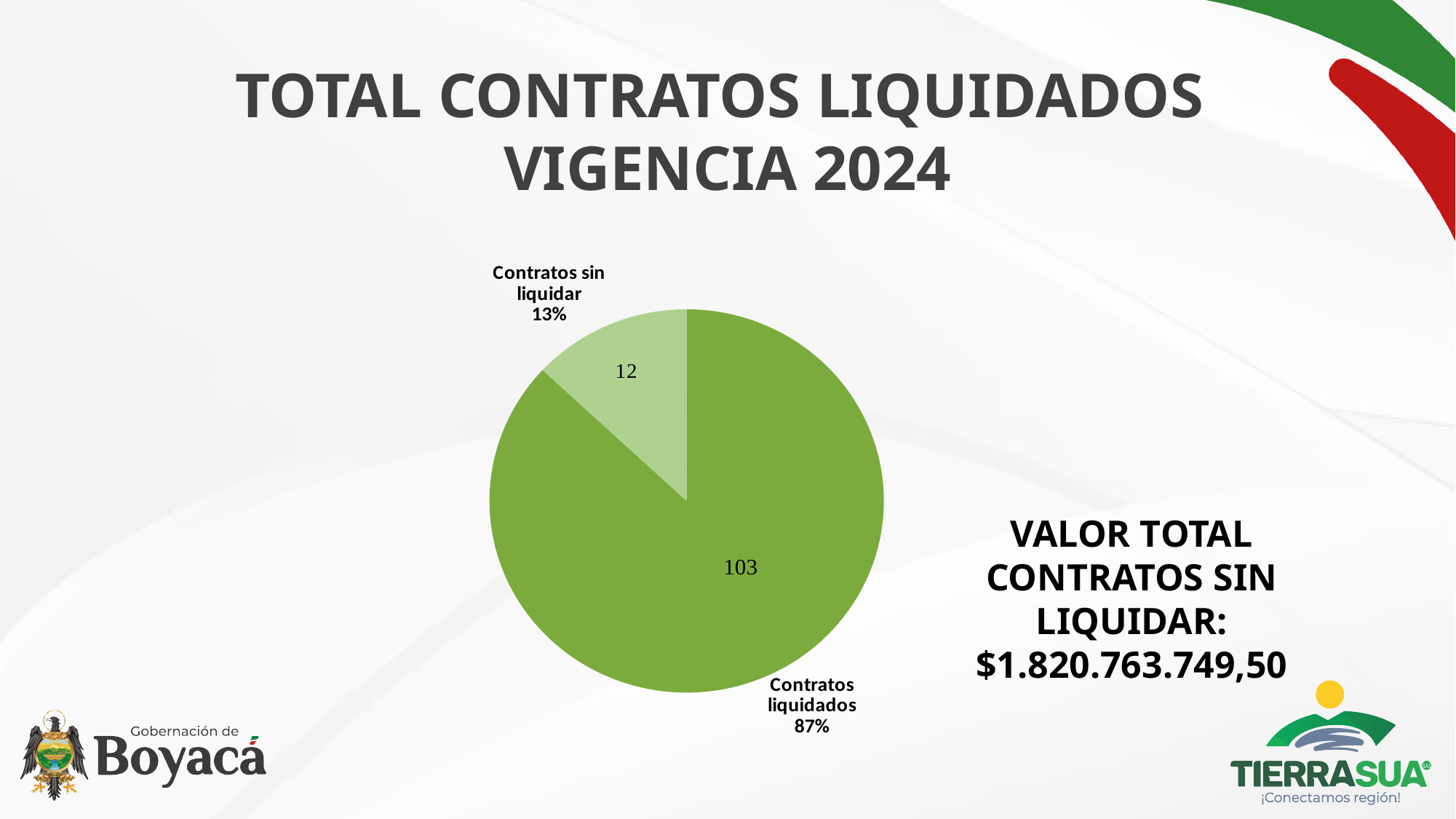
What is the total of the two slices in the pie chart? 115 Which slice is the smallest? Contratos sin liquidar What share of the pie does Contratos sin liquidar represent? 13% Which is larger, Contratos liquidados or Contratos sin liquidar? Contratos liquidados What kind of chart is shown on the slide? pie chart Which slice is the largest? Contratos liquidados What is the value for Contratos sin liquidar? 12 What share of the pie does Contratos liquidados represent? 87% What is the value for Contratos liquidados? 103 What is the title of the slide containing the chart? TOTAL CONTRATOS LIQUIDADOS VIGENCIA 2024 How many slices does the pie chart have? 2 What is the difference between Contratos liquidados and Contratos sin liquidar? 91